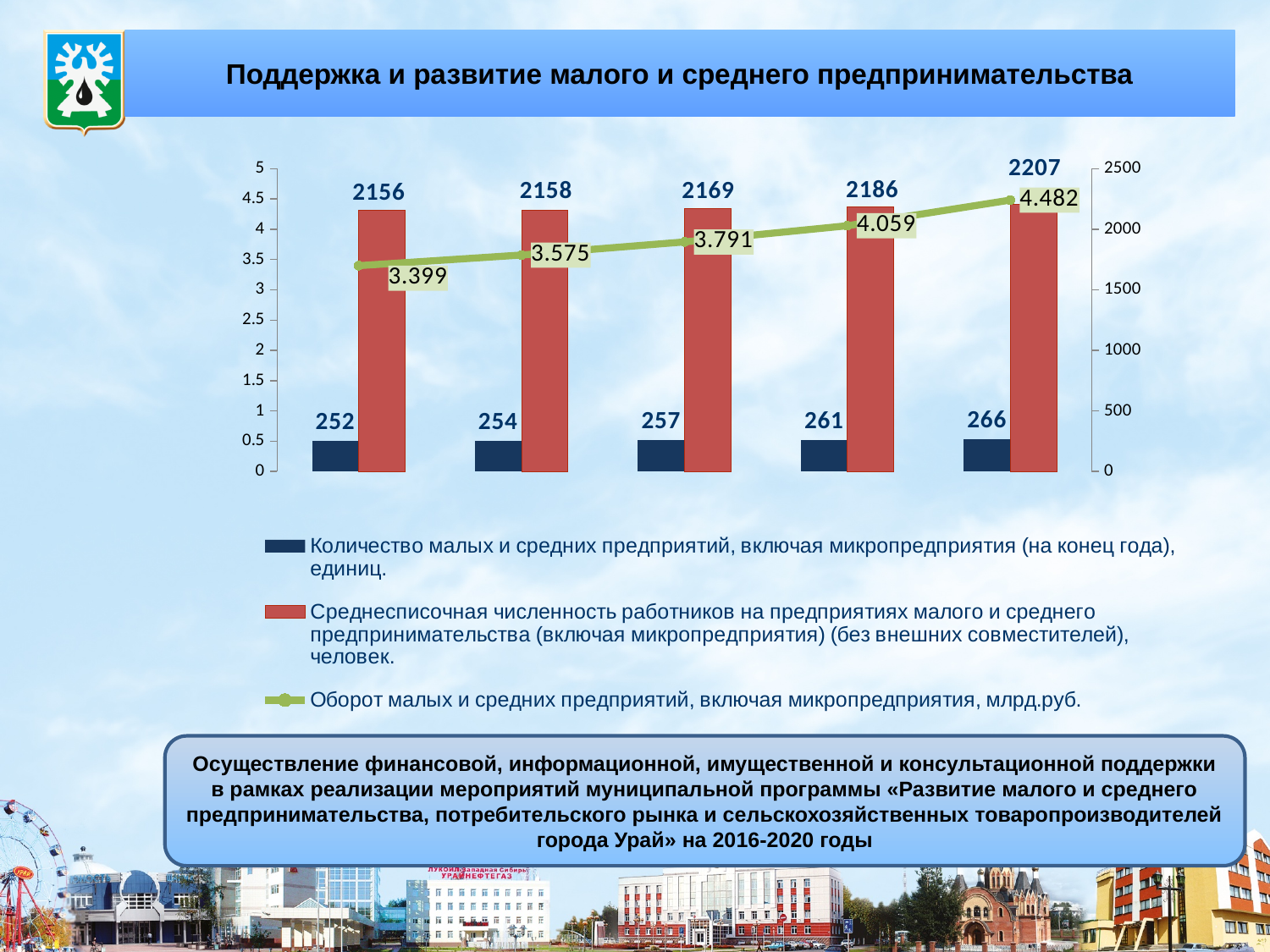
Which group has the highest value for the red bar series (average number of employees)? The last (fifth) group on the right, 2207 What is the difference between the dark blue bar values in the last group and the first group? 14 Do the values of the green turnover line rise or fall from left to right? Rise What is the value of the green line (turnover, billion rubles) at the third point from the left? 3.791 What is the value of the red bar (average number of employees) in the last group on the right? 2207 Which point on the green turnover line has the lowest value? The first point on the left, 3.399 What is the difference between the red bar values in the fifth group and the fourth group? 21 What is the value of the dark blue bar (number of small and medium enterprises) in the first group from the left? 252 Which is larger: the green line value at the second point (3.575) or at the fourth point (4.059)? The fourth point, 4.059 How many series does the legend list? 3 How many groups of bars are plotted on the chart? 5 What kind of chart is shown on the slide? A combined bar and line chart